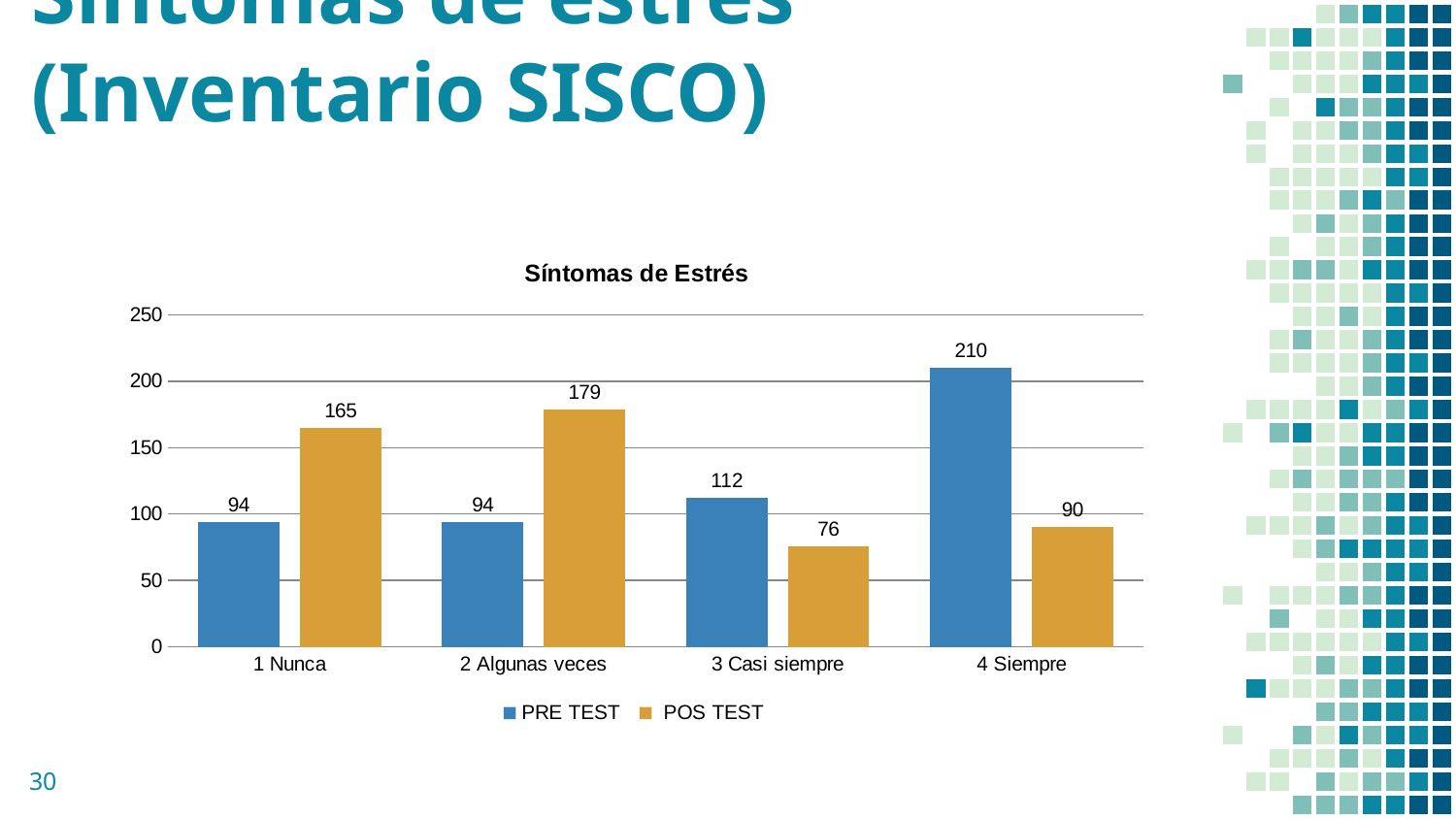
Which category has the highest PRE TEST value? 4 Siempre What is the difference between the POS TEST and PRE TEST values for 1 Nunca? 71 What is the POS TEST value for 2 Algunas veces? 179 What is the title of the chart? Síntomas de Estrés What is the difference between the PRE TEST and POS TEST values for 4 Siempre? 120 How many series does the legend list? 2 Which category has the lowest POS TEST value? 3 Casi siempre What kind of chart is shown? Bar chart Which is larger for 3 Casi siempre, the PRE TEST value or the POS TEST value? PRE TEST What is the PRE TEST value for 4 Siempre? 210 How many categories are shown on the x axis? 4 What is the POS TEST value for 3 Casi siempre? 76